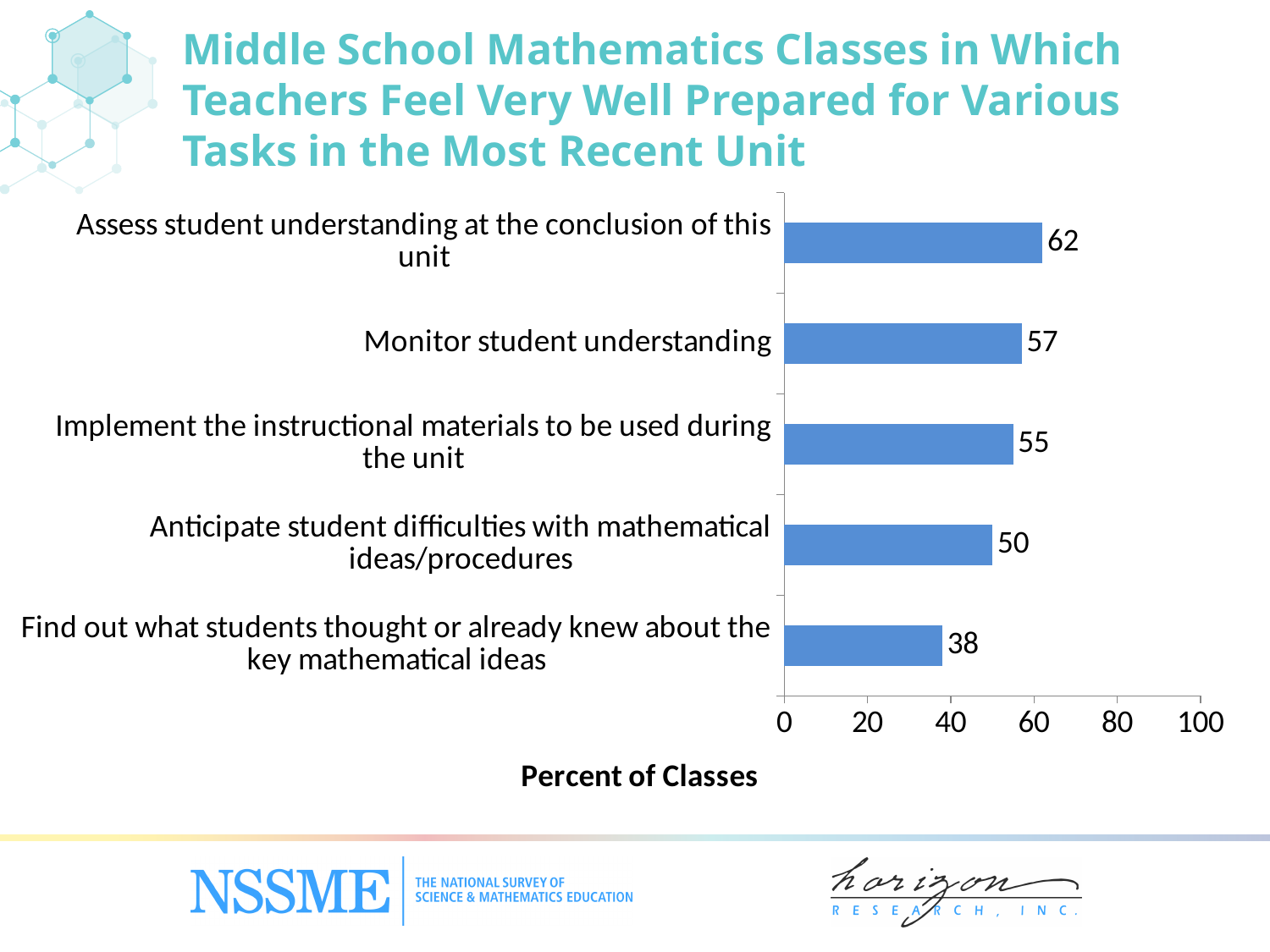
What is the label of the horizontal axis? Percent of Classes What is the value for 'Implement the instructional materials to be used during the unit'? 55 Is the value for 'Anticipate student difficulties with mathematical ideas/procedures' greater or less than 40? greater What is the value for 'Find out what students thought or already knew about the key mathematical ideas'? 38 What kind of chart is shown on the slide? bar chart How many tasks are shown in the chart? 5 What percent of classes have teachers who feel very well prepared to assess student understanding at the conclusion of this unit? 62 Which is larger: the value for 'Monitor student understanding' or the value for 'Anticipate student difficulties with mathematical ideas/procedures'? Monitor student understanding Which task has the highest percent of classes? Assess student understanding at the conclusion of this unit What is the value for 'Monitor student understanding'? 57 What is the difference between the values for 'Assess student understanding at the conclusion of this unit' and 'Find out what students thought or already knew about the key mathematical ideas'? 24 Which task has the lowest percent of classes? Find out what students thought or already knew about the key mathematical ideas